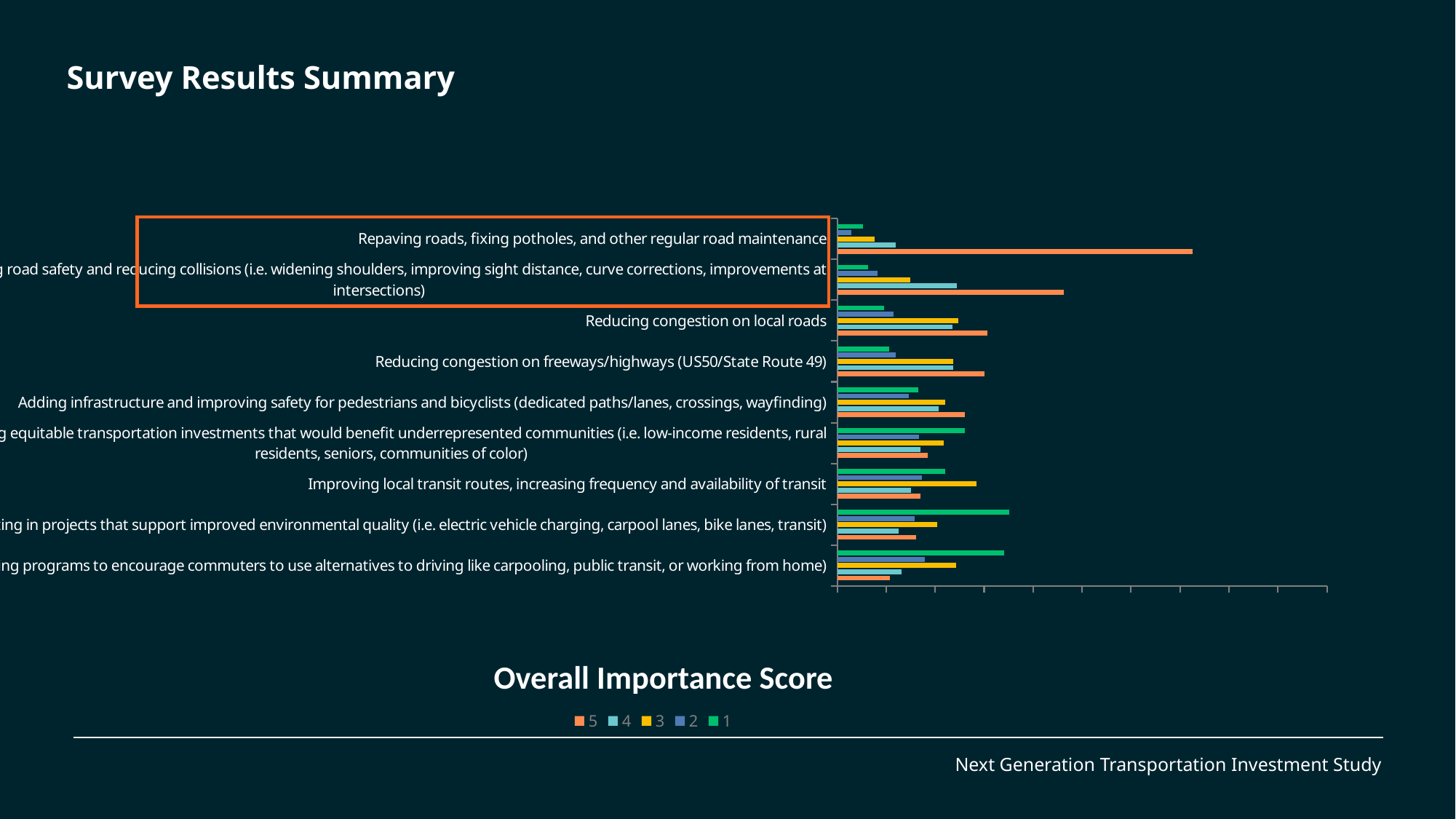
Which category has the longest bar for series 5? Repaving roads, fixing potholes, and other regular road maintenance What kind of chart is shown on the slide? Bar chart For series 4, which is longer: the bar for 'Repaving roads, fixing potholes, and other regular road maintenance' or the bar for the road safety and reducing collisions category? Road safety and reducing collisions Which category has the shortest bar for series 5? Programs to encourage commuters to use alternatives to driving like carpooling, public transit, or working from home For 'Reducing congestion on local roads', is the bar for series 5 or series 1 longer? 5 What is the title of the chart? Overall Importance Score How many series does the legend list? 5 What colour represents series 5 in the legend? Orange How many categories (survey items) are plotted on the chart? 9 For the category about projects that support improved environmental quality, is the bar for series 1 or series 5 longer? 1